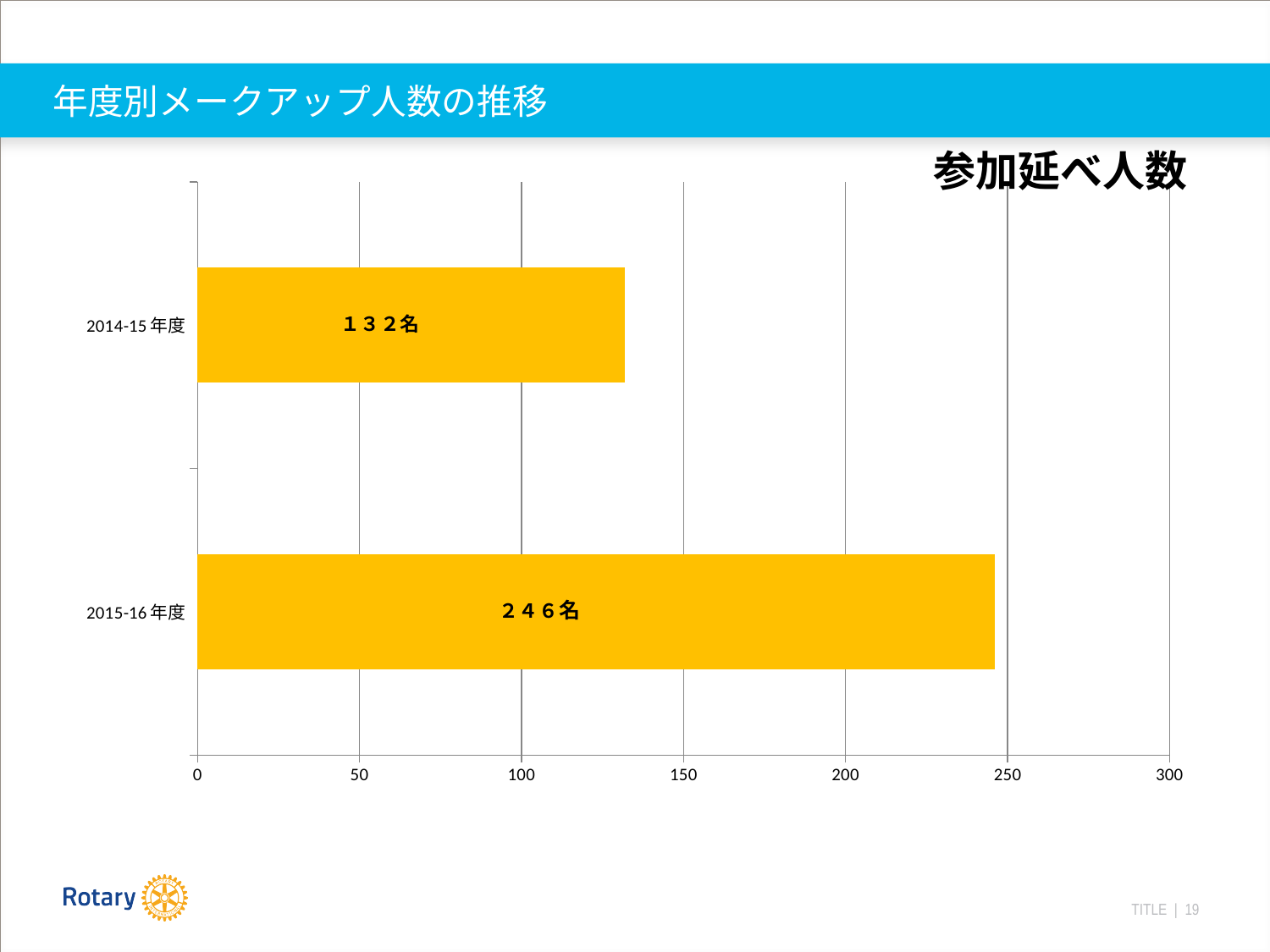
Is the value for 2014-15 年度 greater or less than 150? less Which year has the lowest value? 2014-15 年度 Which year has the highest value? 2015-16 年度 Is the value for 2015-16 年度 greater or less than 200? greater What kind of chart is shown on the slide? bar chart What is the value for 2015-16 年度? ２４６名 Which is larger, the value for 2014-15 年度 or 2015-16 年度? 2015-16 年度 What is the difference between the values for 2015-16 年度 and 2014-15 年度? 114名 What is the title of the chart? 参加延べ人数 What is the value for 2014-15 年度? １３２名 What is the maximum value shown on the horizontal axis? 300 How many categories (years) are shown in the chart? 2